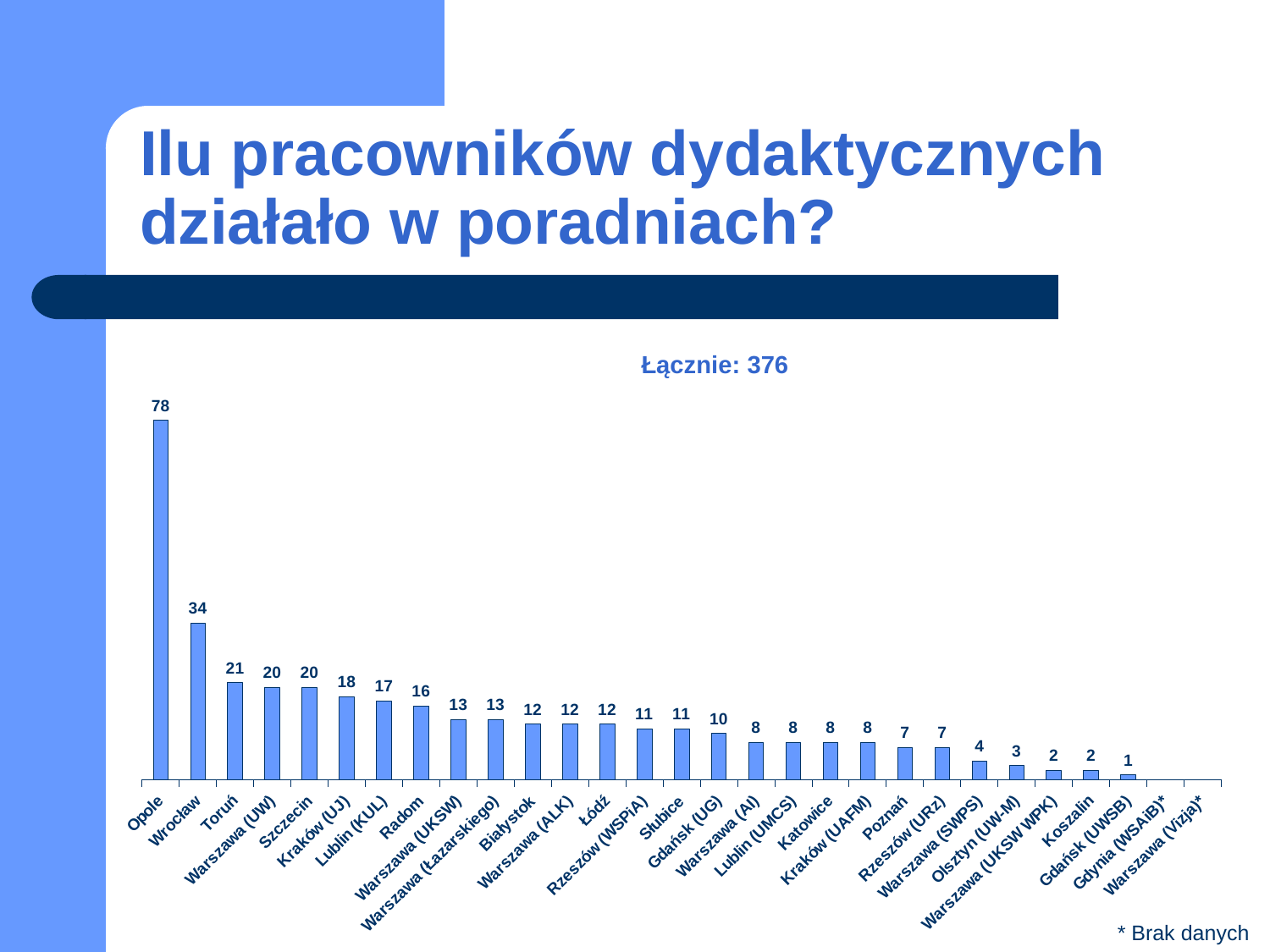
What is the difference between the values for Szczecin and Poznań? 13 What total is given in the chart title? 376 Which category has the highest value? Opole What is the value for Gdańsk (UG)? 10 Which is larger, the value for Toruń or the value for Radom? Toruń What is the value for Opole? 78 What is the value for Wrocław? 34 What kind of chart is shown on the slide? Bar chart What is the difference between the values for Opole and Wrocław? 44 What is the value for Olsztyn (UW-M)? 3 What is the value for Lublin (KUL)? 17 Do the values generally rise or fall from left to right along the x axis? Fall